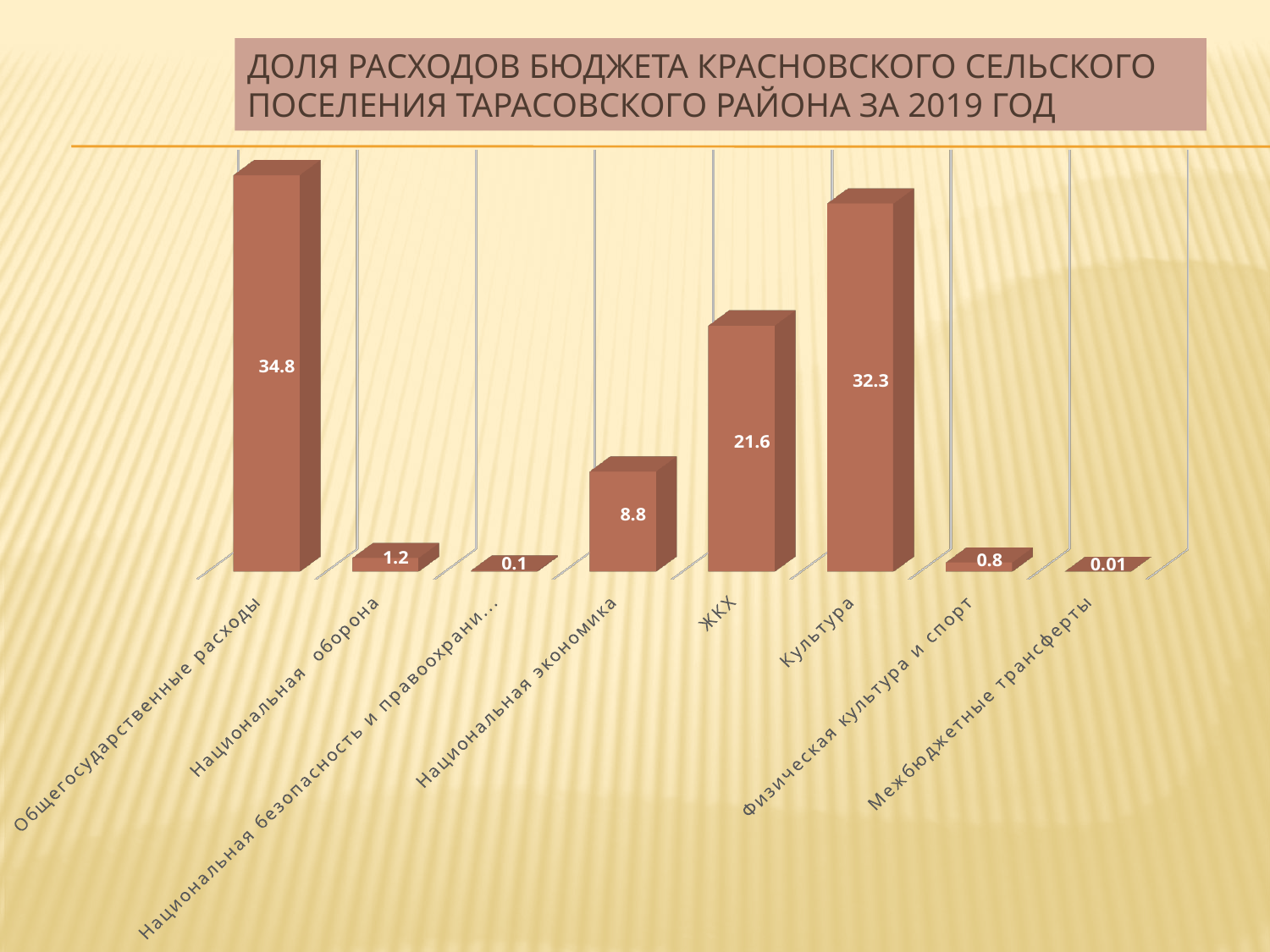
What is the value for Культура? 32.3 Which is larger, the value for Национальная оборона or the value for Физическая культура и спорт? Национальная оборона What is the value for Общегосударственные расходы? 34.8 What is the value for Межбюджетные трансферты? 0.01 What is the difference between the values for Общегосударственные расходы and Культура? 2.5 What is the difference between the values for ЖКХ and Национальная экономика? 12.8 Which category has the lowest value? Межбюджетные трансферты What kind of chart is shown on the slide? Bar chart What is the value for Национальная экономика? 8.8 Which category has the highest value? Общегосударственные расходы What is the value for ЖКХ? 21.6 How many categories are shown in the chart? 8